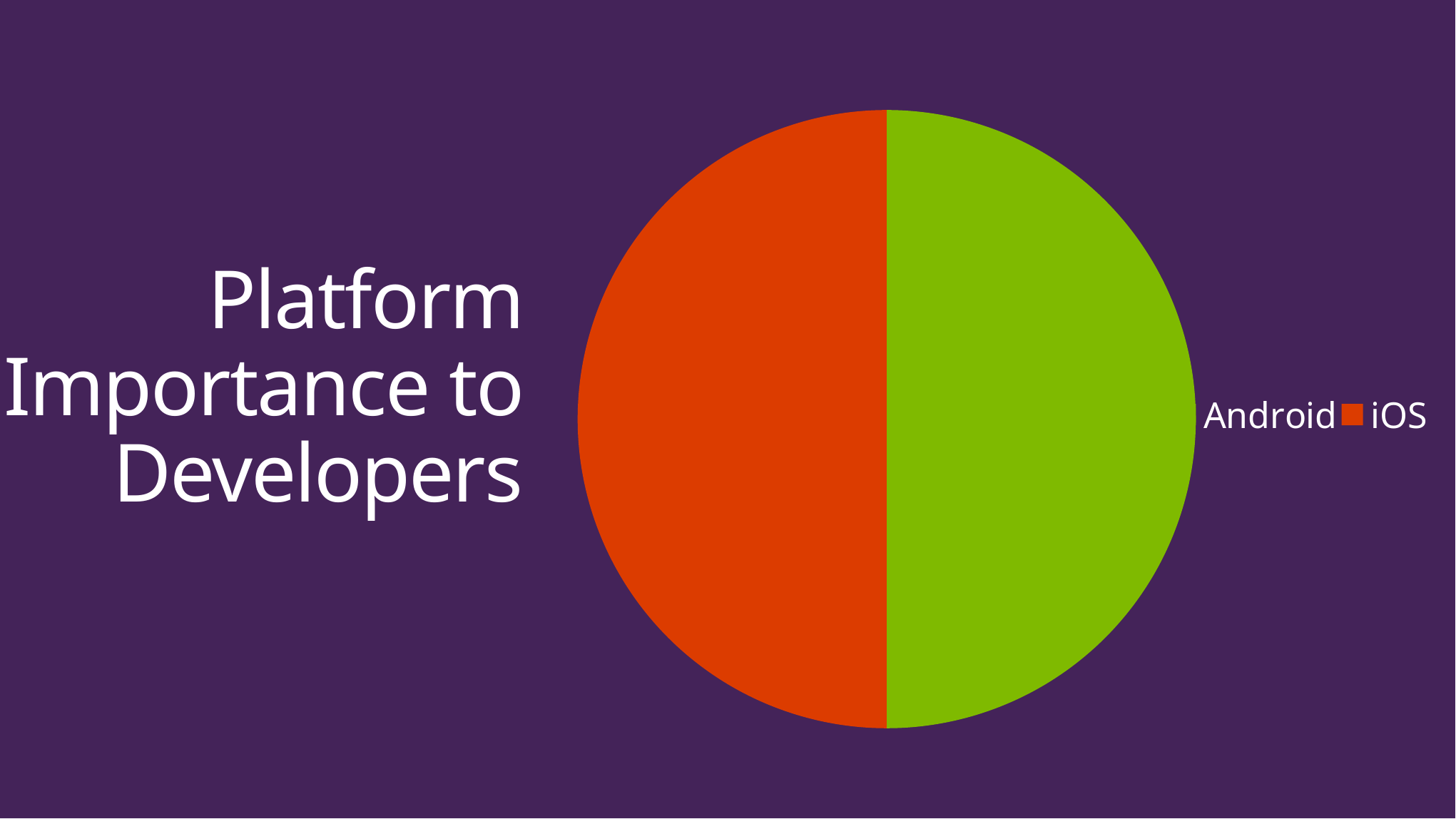
How many slices does the pie chart have? 2 Do the Android and iOS slices of the pie chart appear equal in size? yes What kind of chart is shown on the slide? pie chart How many entries does the legend of the pie chart list? 2 What is the title shown next to the pie chart? Platform Importance to Developers What are the two categories shown in the pie chart's legend? Android and iOS